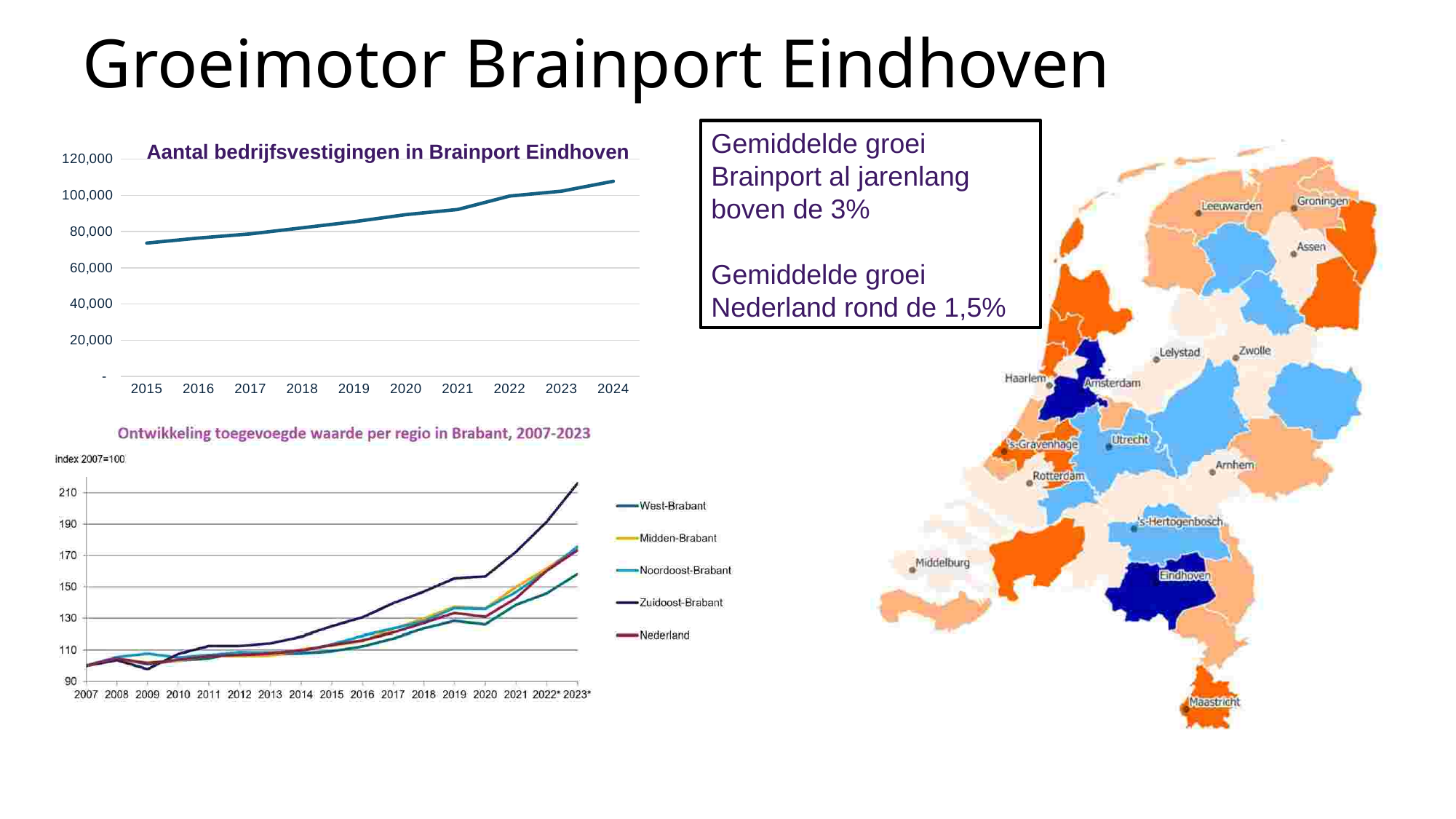
What index base is stated on the y axis of the 'Ontwikkeling toegevoegde waarde per regio in Brabant, 2007-2023' chart? index 2007=100 What kind of chart is the 'Aantal bedrijfsvestigingen in Brainport Eindhoven' chart? line chart In the 'Ontwikkeling toegevoegde waarde per regio in Brabant, 2007-2023' chart, which series has the lowest value in 2023*? West-Brabant How many series does the legend of the 'Ontwikkeling toegevoegde waarde per regio in Brabant, 2007-2023' chart list? 5 In the 'Ontwikkeling toegevoegde waarde per regio in Brabant, 2007-2023' chart, which region has the highest value in 2023*? Zuidoost-Brabant In the 'Ontwikkeling toegevoegde waarde per regio in Brabant, 2007-2023' chart, is the value for Zuidoost-Brabant in 2023* greater or less than 210? greater In the 'Ontwikkeling toegevoegde waarde per regio in Brabant, 2007-2023' chart, is the value for West-Brabant in 2023* greater or less than 170? less In the 'Aantal bedrijfsvestigingen in Brainport Eindhoven' chart, is the value for 2021 greater or less than 100,000? less How many years are shown on the x axis of the 'Aantal bedrijfsvestigingen in Brainport Eindhoven' chart? 10 In the 'Aantal bedrijfsvestigingen in Brainport Eindhoven' chart, do the values rise or fall from 2015 to 2024? rise